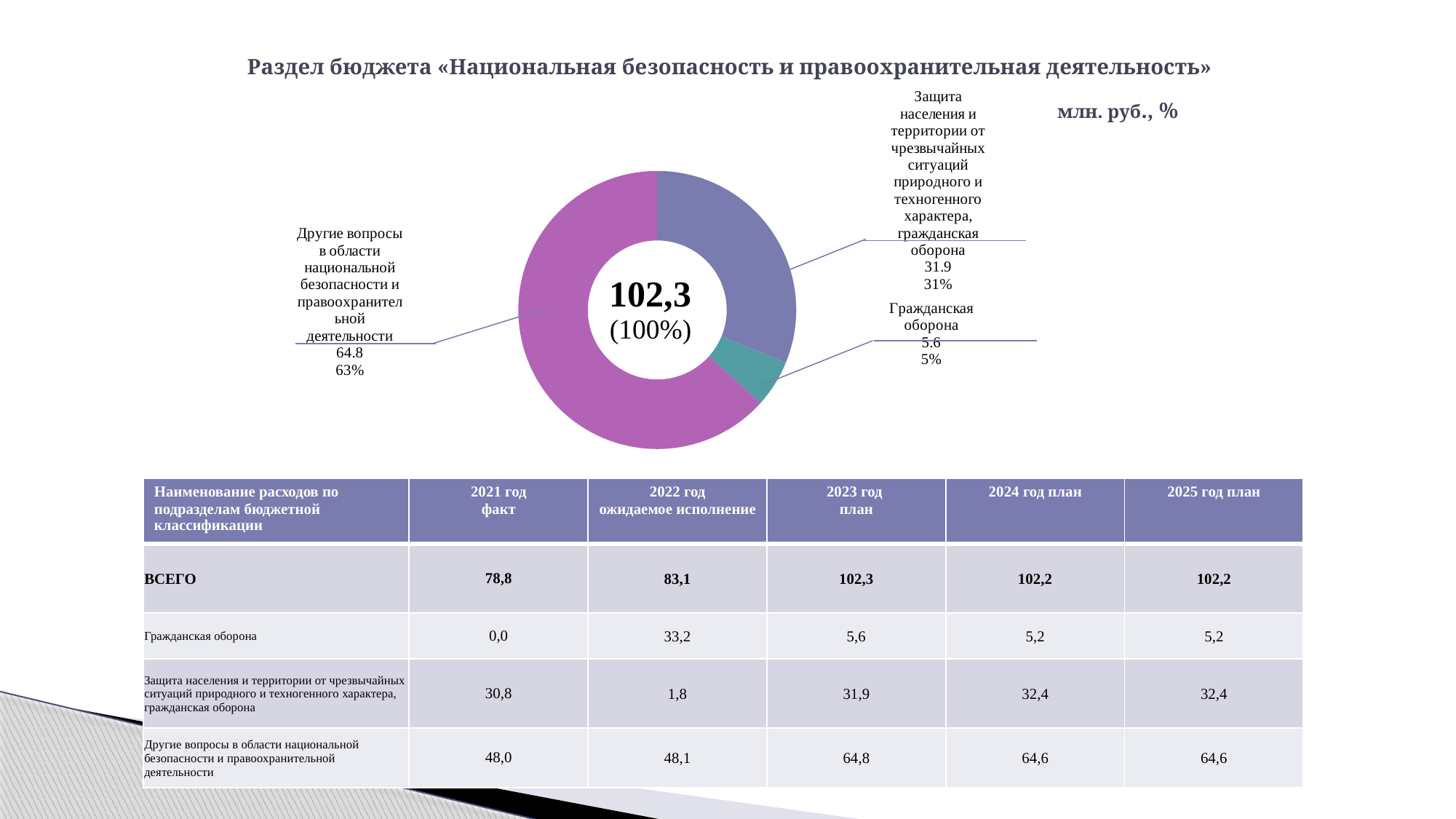
Which slice of the donut chart is the smallest? Гражданская оборона What is the value shown for «Гражданская оборона» on the donut chart? 5.6 How many slices does the donut chart have? 3 What units are indicated for the donut chart? млн. руб., % What kind of chart is shown on the slide? Donut (pie) chart What share of the donut chart does «Гражданская оборона» represent? 5% What is the difference between the values for «Другие вопросы в области национальной безопасности и правоохранительной деятельности» and «Защита населения и территории от чрезвычайных ситуаций природного и техногенного характера, гражданская оборона» on the donut chart? 32.9 What total value is shown in the centre of the donut chart? 102,3 What share of the donut chart does «Защита населения и территории от чрезвычайных ситуаций природного и техногенного характера, гражданская оборона» represent? 31% Which slice of the donut chart is the largest? Другие вопросы в области национальной безопасности и правоохранительной деятельности What is the value shown for «Защита населения и территории от чрезвычайных ситуаций природного и техногенного характера, гражданская оборона» on the donut chart? 31.9 What is the value shown for «Другие вопросы в области национальной безопасности и правоохранительной деятельности» on the donut chart? 64.8